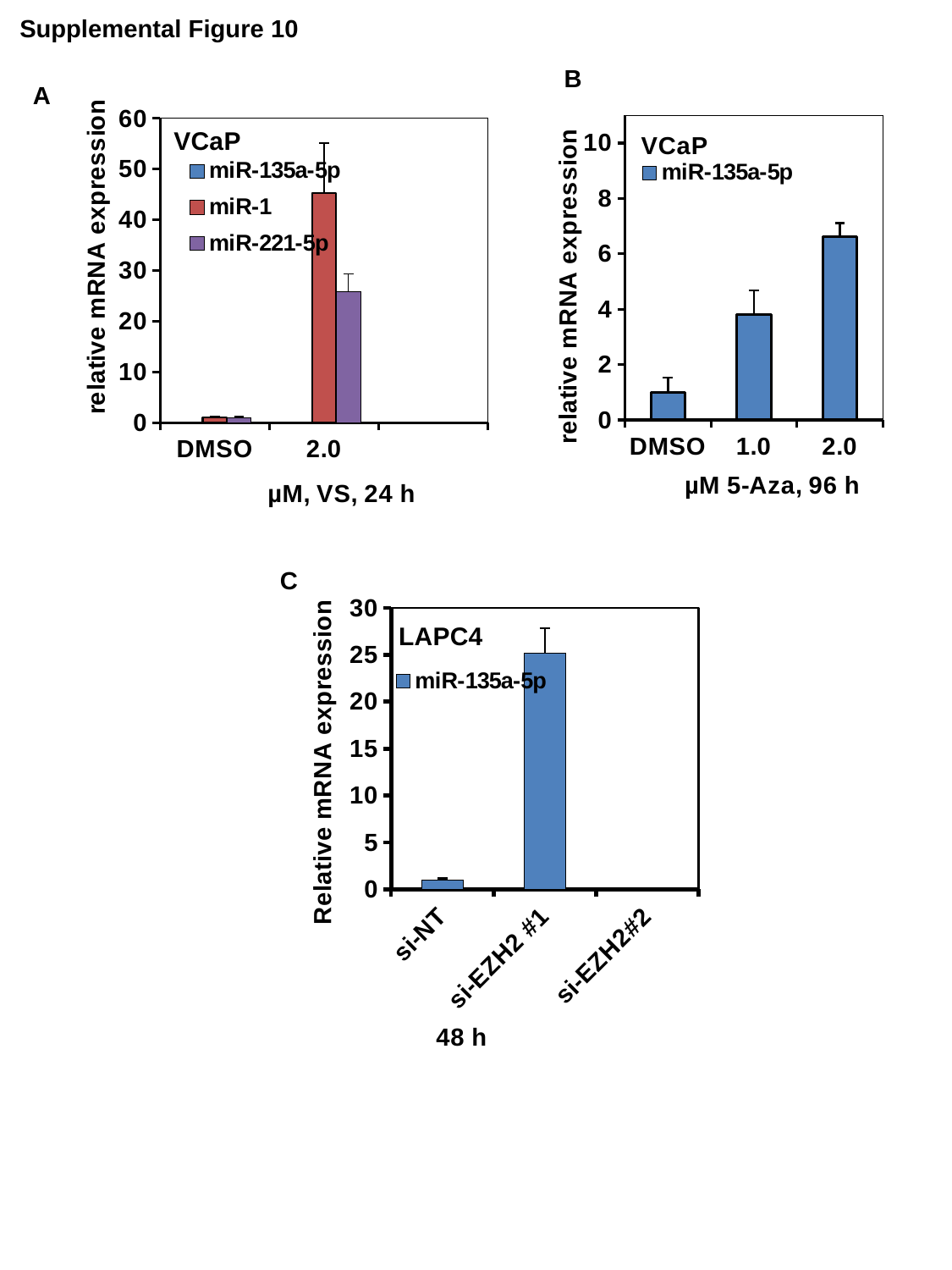
In chart B (VCaP, μM 5-Aza, 96 h), is the value for 2.0 greater or less than 6? greater In chart C (LAPC4, 48 h), is the value for si-EZH2 #1 greater or less than 20? greater In chart B (VCaP, μM 5-Aza, 96 h), do the values rise or fall from DMSO to 2.0? rise What kind of chart is chart B (VCaP, μM 5-Aza, 96 h)? bar chart In chart B (VCaP, μM 5-Aza, 96 h), which category has the highest value? 2.0 In chart A (VCaP, μM, VS, 24 h), how many series does the legend list? 3 In chart C (LAPC4, 48 h), which category has the highest value? si-EZH2 #1 In chart C (LAPC4, 48 h), which series does the legend list? miR-135a-5p In chart A (VCaP, μM, VS, 24 h), is the value for miR-221-5p at 2.0 greater or less than 30? less In chart A (VCaP, μM, VS, 24 h), which series has the larger value at 2.0, miR-1 or miR-221-5p? miR-1 In chart B (VCaP, μM 5-Aza, 96 h), how many categories are shown on the x axis? 3